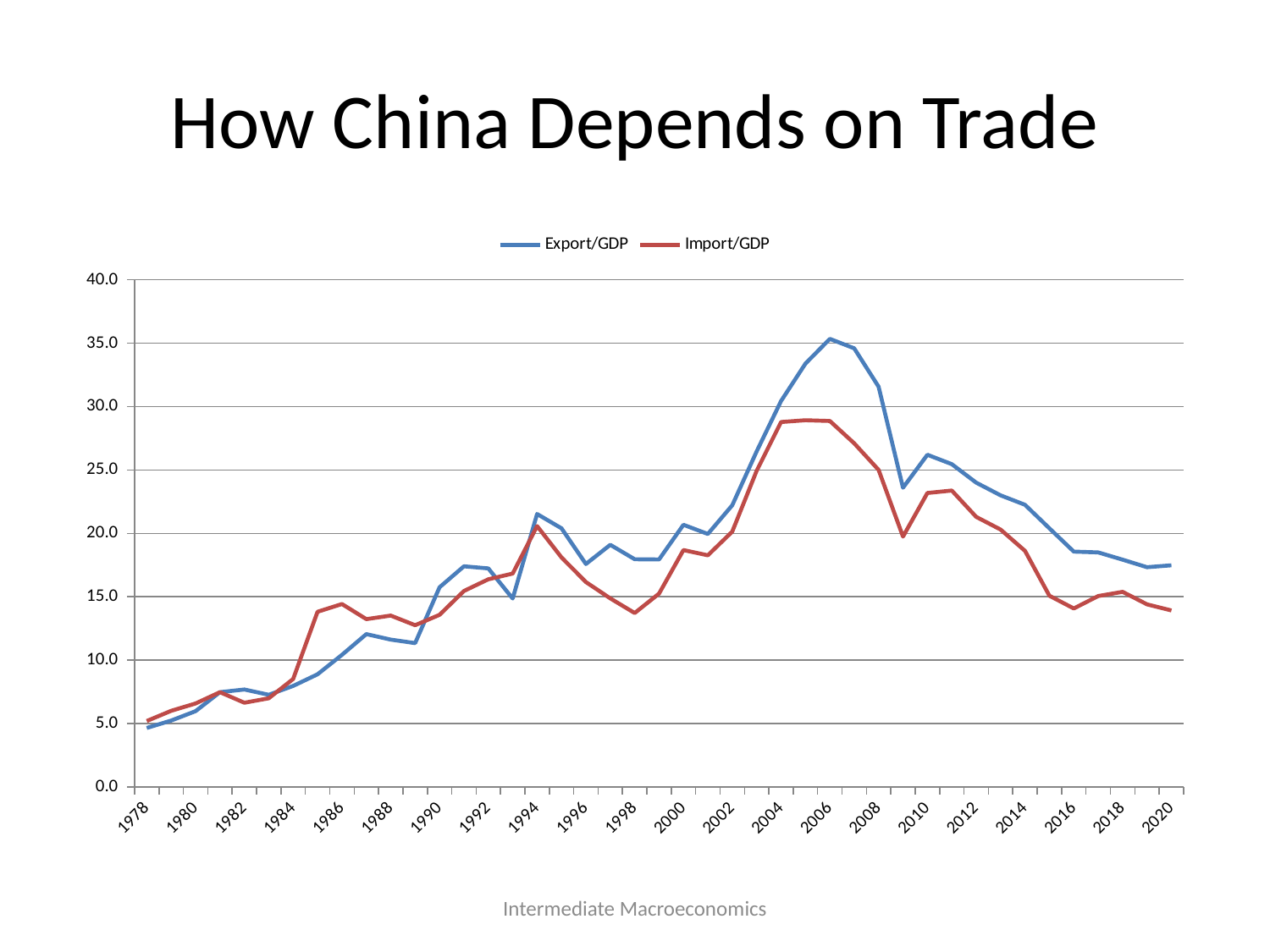
Is the value for Export/GDP in 2006 greater or less than 30.0? greater In which year is Export/GDP at its lowest? 1978 From 2006 to 2020, does Export/GDP generally rise or fall? fall In 1986, which is higher, Export/GDP or Import/GDP? Import/GDP How many series does the legend list? 2 What are the two series named in the legend? Export/GDP and Import/GDP Is the value for Import/GDP in 2009 greater or less than 25.0? less Is the value for Import/GDP in 2020 greater or less than 15.0? less In which year does Export/GDP reach its highest value? 2006 What kind of chart is shown on the slide? line chart In 2006, which is higher, Export/GDP or Import/GDP? Export/GDP What is the title of the chart? How China Depends on Trade